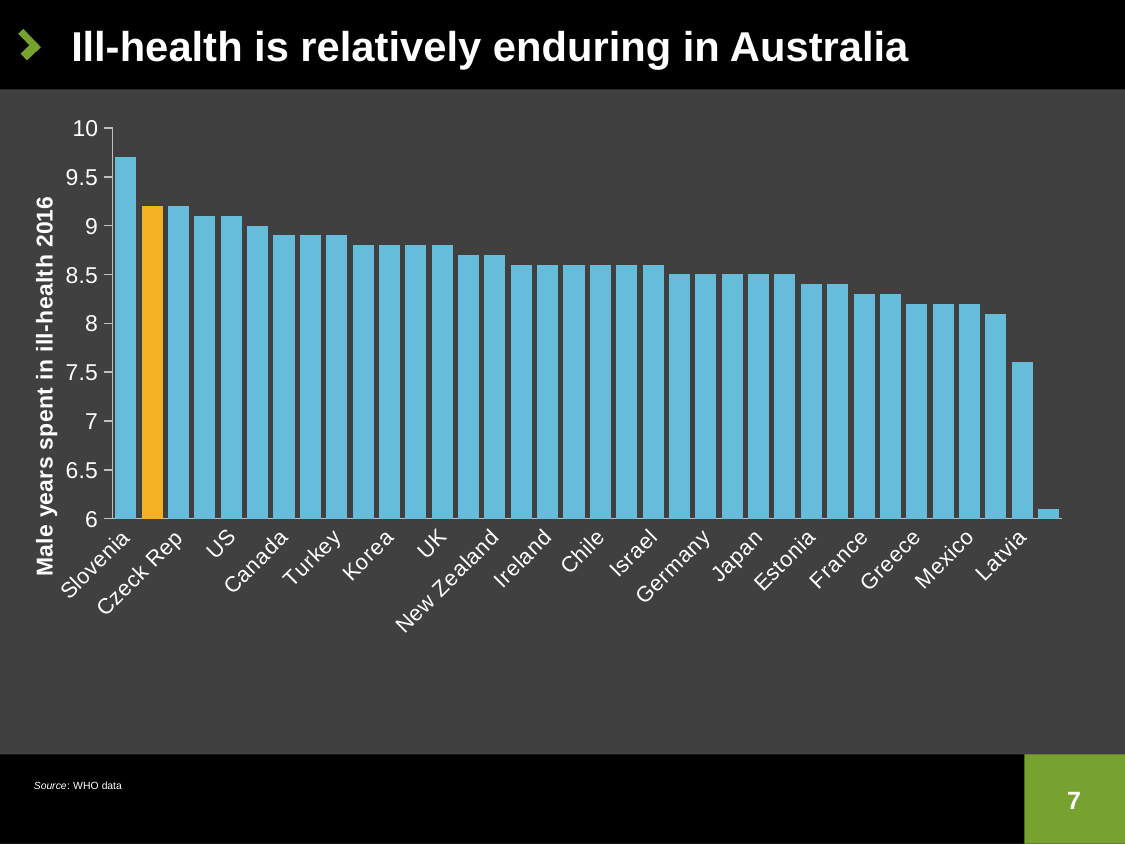
Which labelled country has the highest value for male years spent in ill-health 2016? Slovenia Is the value for Slovenia greater or less than 9.5? greater Is the value for Czech Rep greater or less than 9? greater Do the bar values rise or fall from left to right along the x axis? fall Is the value for Latvia greater or less than 8? less How many country labels are shown on the x axis? 18 Which has a higher value, Greece or Czech Rep? Czech Rep What kind of chart is shown on the slide? bar chart Which has a higher value, Slovenia or Latvia? Slovenia What is the title of the y axis? Male years spent in ill-health 2016